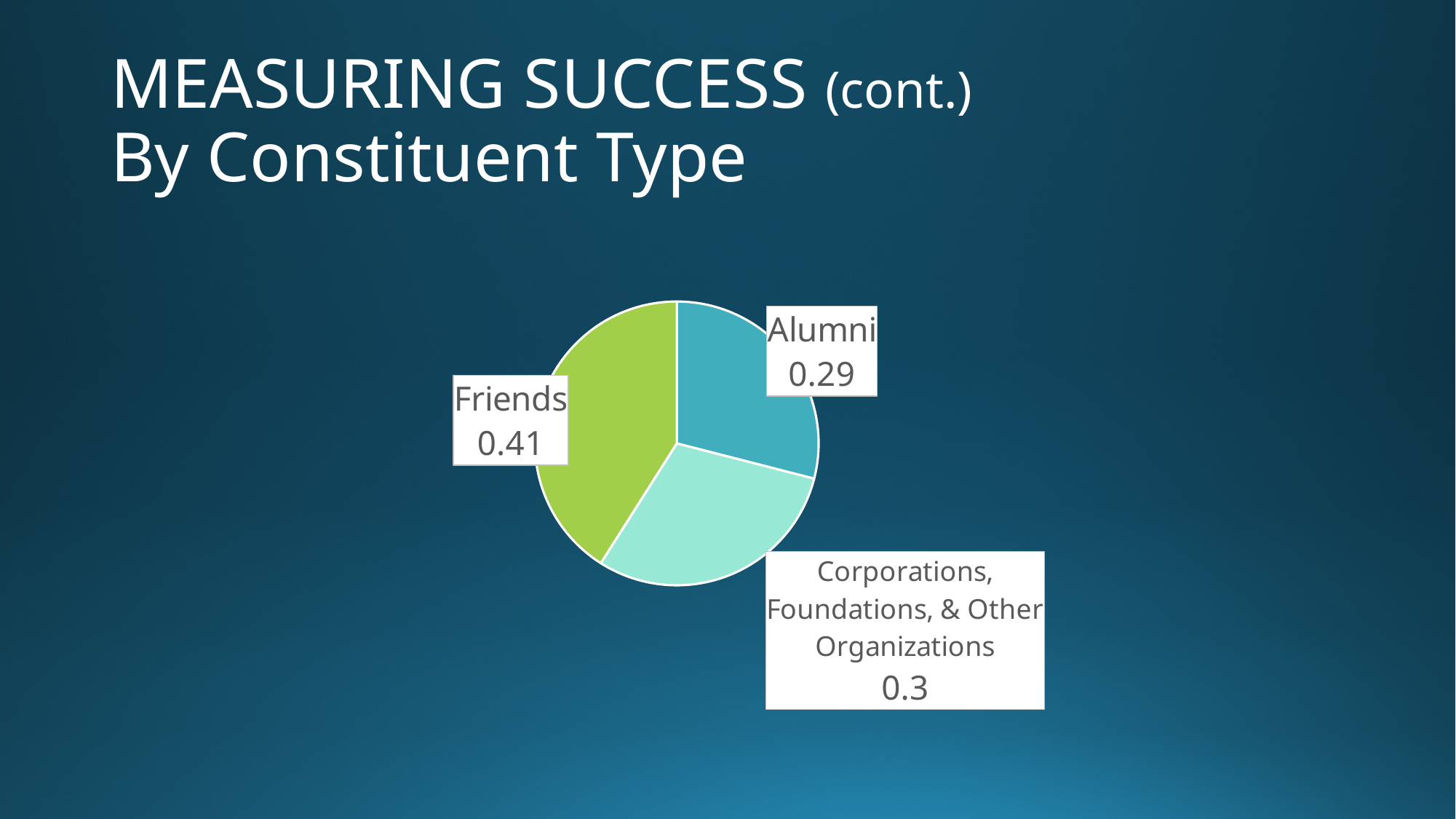
What is the value for Corporations, Foundations, & Other Organizations? 0.3 What kind of chart is shown on the slide? pie chart What is the value for Alumni? 0.29 What colour is the Friends slice? green Which category has the smallest slice? Alumni Which is larger, the value for Friends or the value for Alumni? Friends What is the value for Friends? 0.41 How many slices does the pie chart have? 3 What is the difference between the values for Friends and Corporations, Foundations, & Other Organizations? 0.11 Which category has the largest slice? Friends What is the difference between the values for Friends and Alumni? 0.12 What is the slide title above the chart? MEASURING SUCCESS (cont.) By Constituent Type